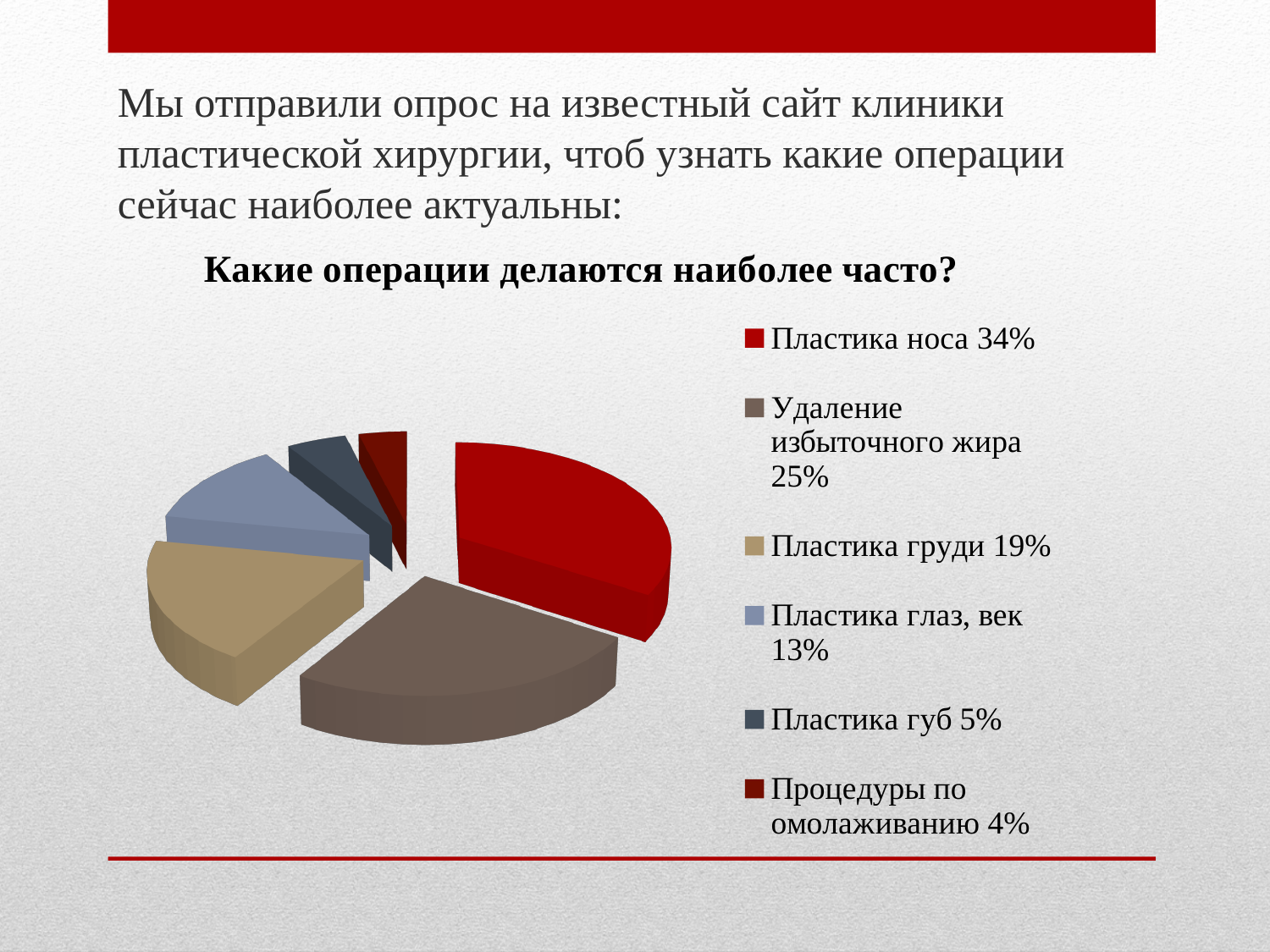
What share does "Пластика носа" have in the pie chart? 34% What share does "Удаление избыточного жира" have in the pie chart? 25% Which is larger: the share for "Пластика губ" or the share for "Процедуры по омолаживанию"? Пластика губ What colour is the slice for "Пластика груди"? tan (beige) What share does "Пластика глаз, век" have in the pie chart? 13% Which category has the smallest share of the pie? Процедуры по омолаживанию What kind of chart is shown on the slide? pie chart Which category has the largest share of the pie? Пластика носа What is the difference in percentage points between "Пластика носа" and "Пластика груди"? 15 How many categories does the pie chart have? 6 What is the difference in percentage points between "Удаление избыточного жира" and "Пластика глаз, век"? 12 What is the title of the chart? Какие операции делаются наиболее часто?